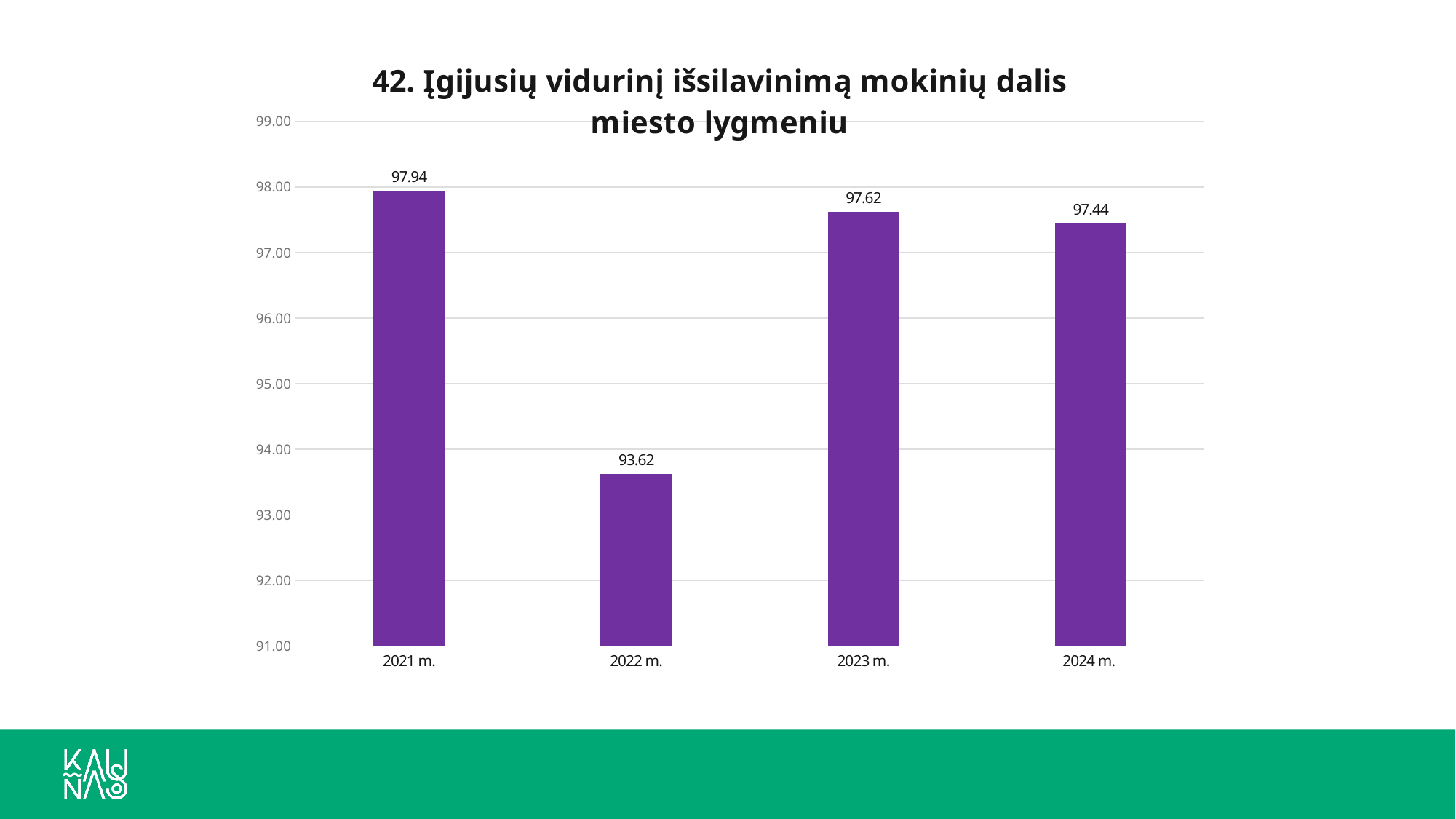
Which year has the highest value? 2021 m. What is the value for 2021 m.? 97.94 What is the value for 2022 m.? 93.62 What is the difference between the values for 2021 m. and 2022 m.? 4.32 Which is larger, the value for 2023 m. or the value for 2024 m.? 2023 m. Which year has the lowest value? 2022 m. What kind of chart is shown on the slide? bar chart What is the value for 2024 m.? 97.44 How many years are shown on the x axis? 4 Is the value for 2022 m. greater or less than 94.00? less What is the value for 2023 m.? 97.62 What is the difference between the values for 2023 m. and 2024 m.? 0.18